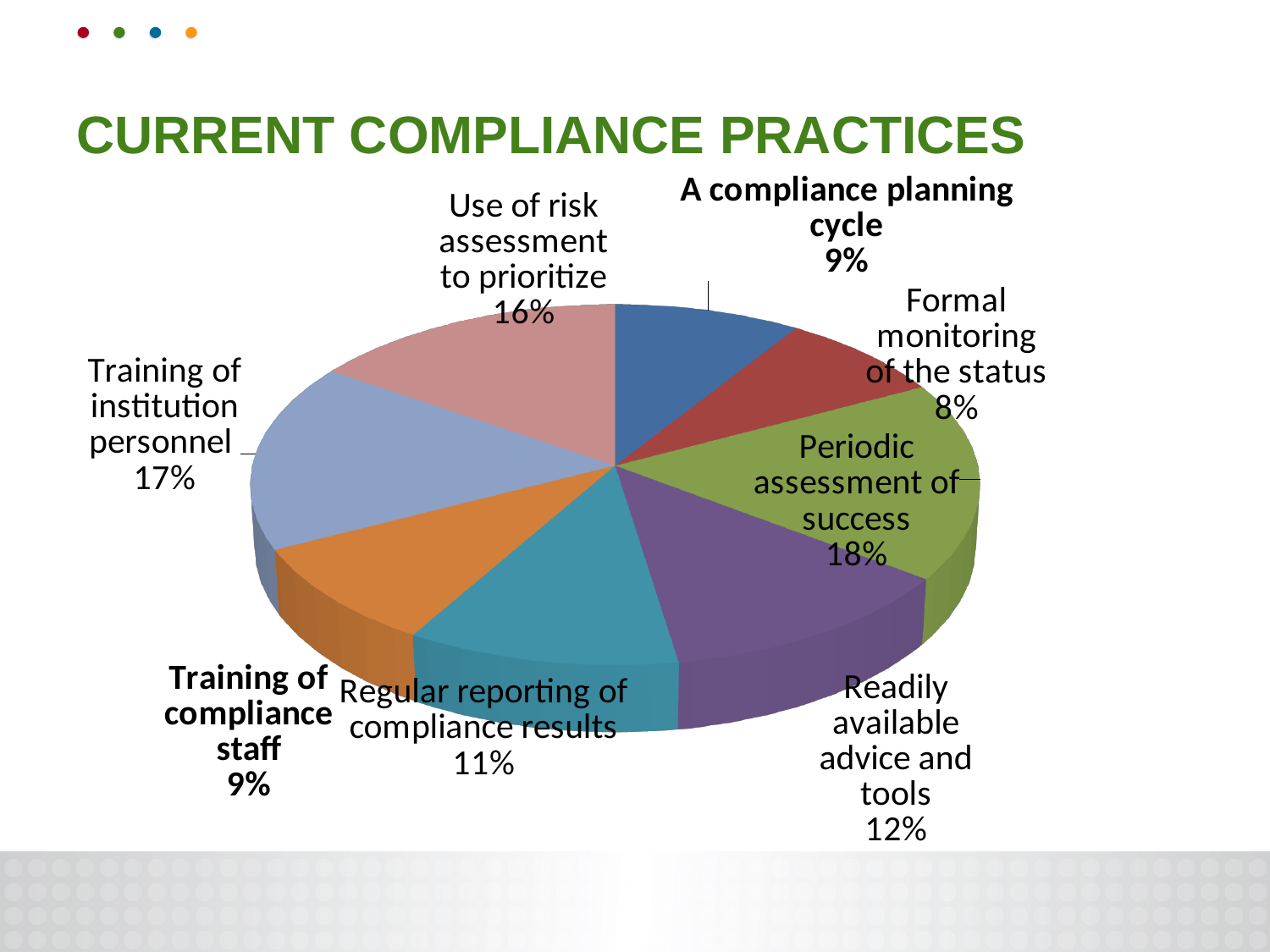
What percentage is shown for Periodic assessment of success? 18% How many slices does the pie chart have? 8 What percentage is shown for Training of institution personnel? 17% What percentage is shown for Readily available advice and tools? 12% Which category has the largest share of the pie? Periodic assessment of success What is the difference in percentage points between Use of risk assessment to prioritize and Formal monitoring of the status? 8 Which is larger, the share for Readily available advice and tools or the share for Training of compliance staff? Readily available advice and tools What is the title of the slide's chart? CURRENT COMPLIANCE PRACTICES What percentage is shown for Regular reporting of compliance results? 11% What kind of chart is shown on the slide? pie chart What is the combined share of A compliance planning cycle and Training of compliance staff? 18% Which category has the smallest share of the pie? Formal monitoring of the status